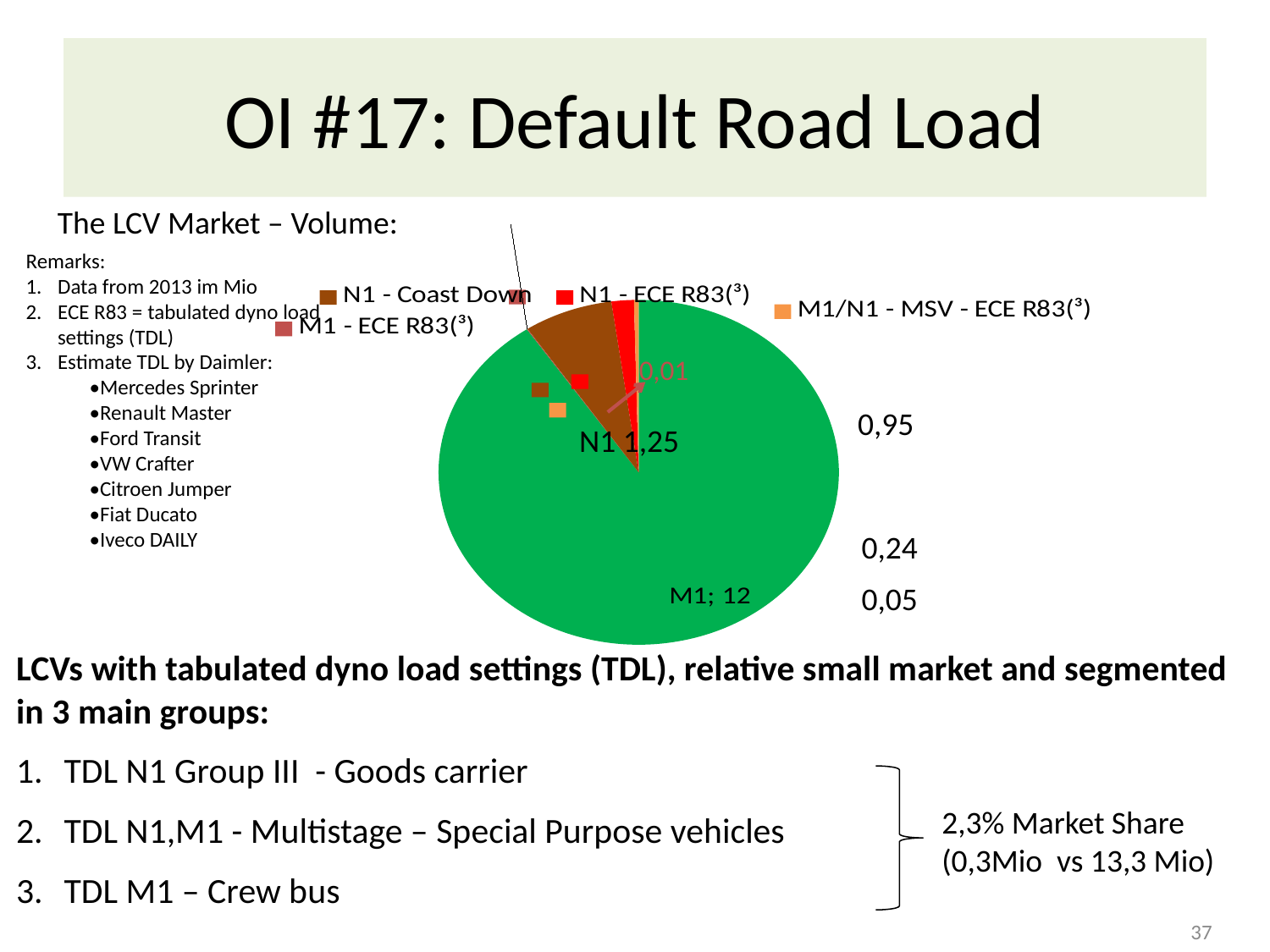
Which is larger in the pie chart, the M1 slice or the N1 slice? M1 What kind of chart is shown on the slide? pie chart How many entries does the legend of the pie chart list? 4 What is the first entry listed in the pie chart's legend? N1 - Coast Down Which slice of the pie chart is the largest? M1 What is the difference between the M1 value (12) and the N1 value (1,25) in the pie chart? 10,75 What colour is the largest slice of the pie chart? green What value is labelled for the N1 slice of the pie chart? 1,25 What value is labelled for the M1 slice of the pie chart? 12